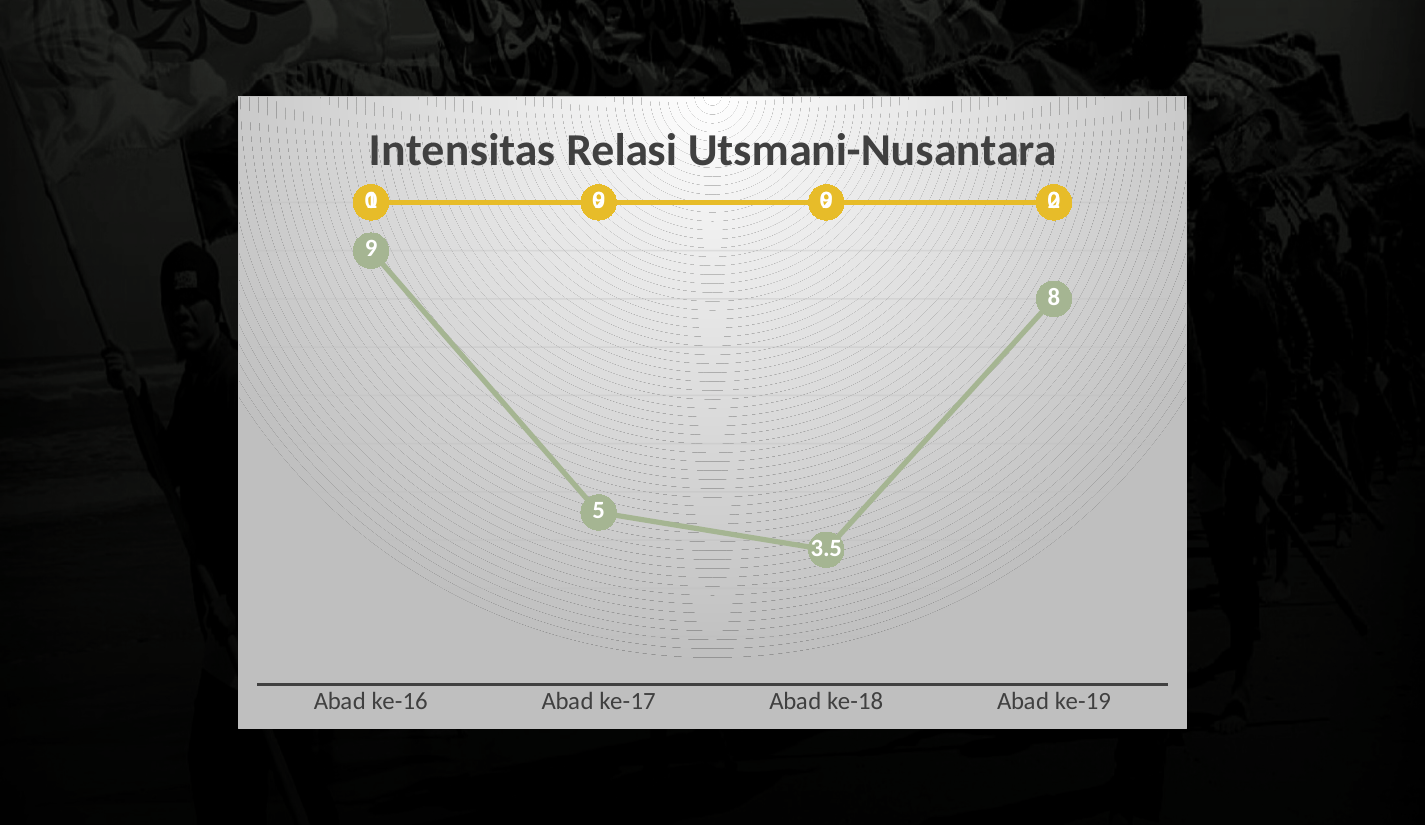
What is the value of the green line at Abad ke-18? 3.5 Which is larger on the green line: the value at Abad ke-17 or at Abad ke-19? Abad ke-19 What is the difference between the green line's values at Abad ke-16 and Abad ke-18? 5.5 At which century does the green line reach its lowest value? Abad ke-18 How many categories are shown on the x axis? 4 What is the value of the green line at Abad ke-19? 8 At which century does the green line reach its highest value? Abad ke-16 What is the value of the green line at Abad ke-16? 9 Does the green line rise or fall from Abad ke-16 to Abad ke-18? Fall What is the value of the green line at Abad ke-17? 5 What is the title of the chart? Intensitas Relasi Utsmani-Nusantara What type of chart is shown on the slide? Line chart